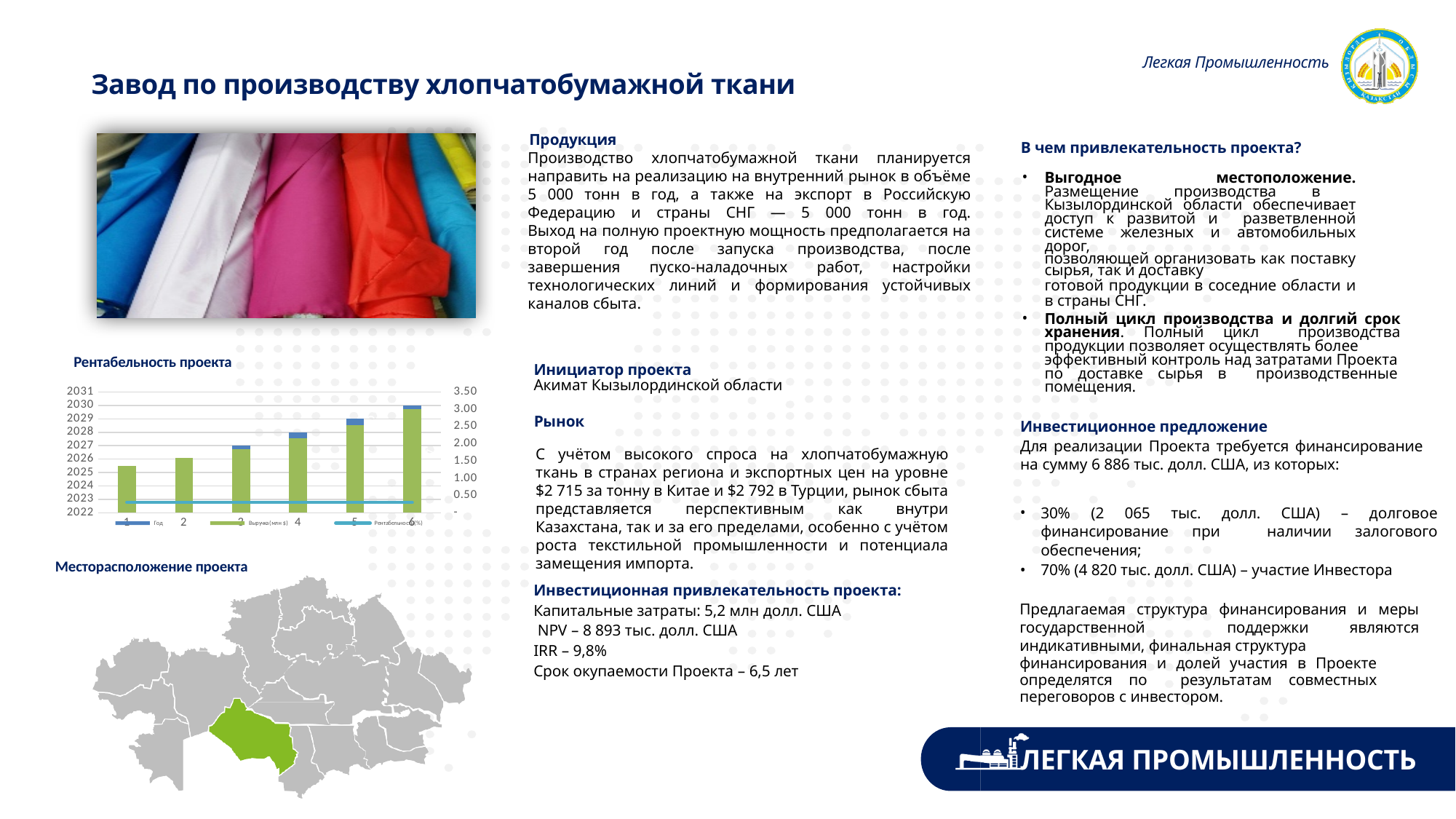
What kind of chart is the 'Рентабельность проекта' chart? combination bar and line chart How many categories are shown along the x axis of the 'Рентабельность проекта' chart? 6 In the 'Рентабельность проекта' chart, is the green 'Выручка (млн $)' bar for category 1 greater or less than 2.00 on the right axis? less In the 'Рентабельность проекта' chart, is the green 'Выручка (млн $)' bar larger for category 2 or category 5? category 5 In the 'Рентабельность проекта' chart, which series is drawn as a line rather than bars? Рентабельность (%) How many series does the legend of the 'Рентабельность проекта' chart list? 3 In the 'Рентабельность проекта' chart, do the green 'Выручка (млн $)' bars rise or fall from category 1 to category 6? rise What is the title of the chart on the slide? Рентабельность проекта In the 'Рентабельность проекта' chart, which category has the shortest green 'Выручка (млн $)' bar? 1 In the 'Рентабельность проекта' chart, is the green 'Выручка (млн $)' bar for category 6 greater or less than 2.00 on the right axis? greater In the 'Рентабельность проекта' chart, which category has the tallest green 'Выручка (млн $)' bar? 6